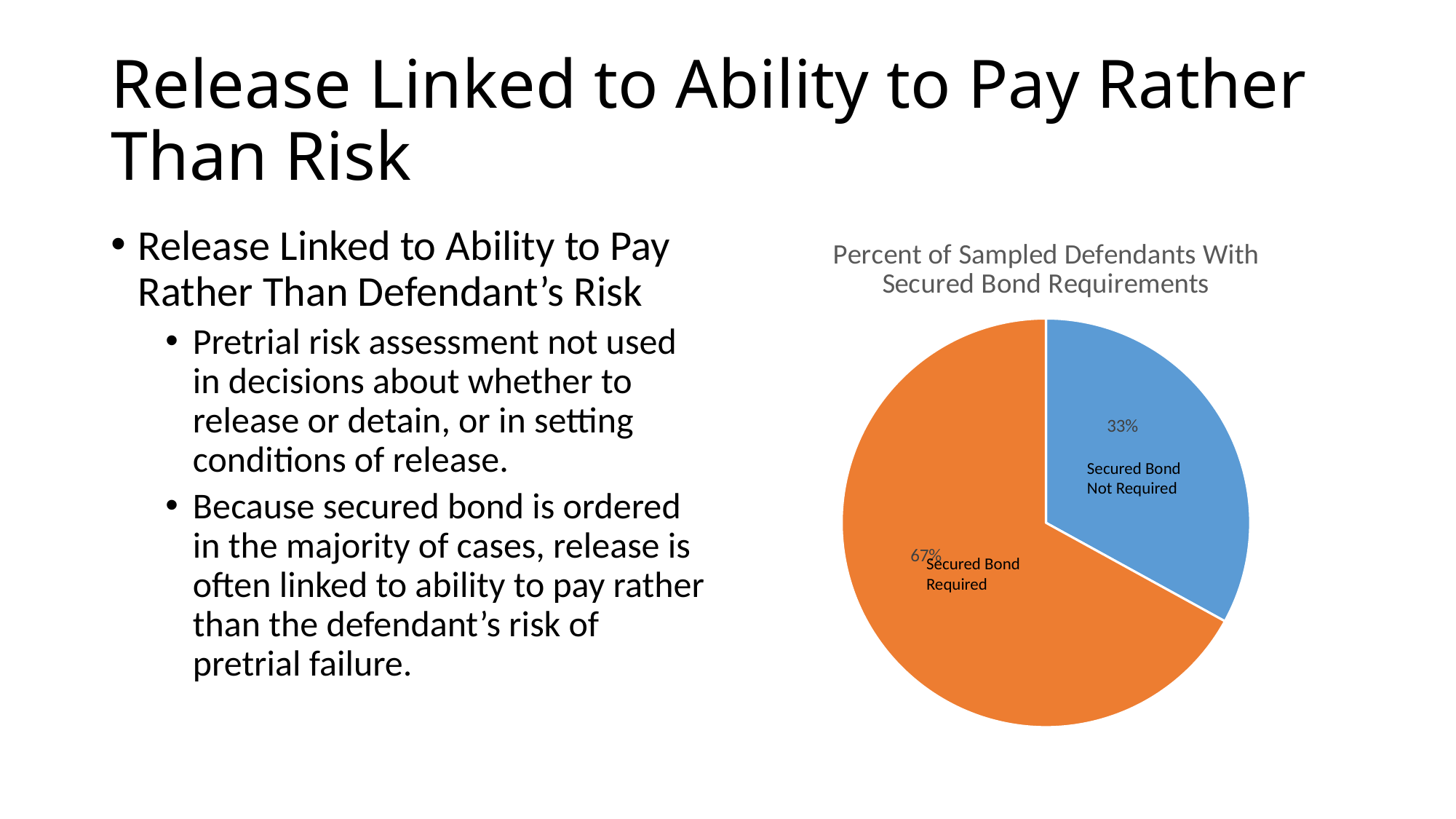
Which is larger: the share for Secured Bond Required or Secured Bond Not Required? Secured Bond Required Which slice of the pie is the largest? Secured Bond Required What colour is the Secured Bond Required slice? orange How many slices does the pie chart have? 2 What percentage of sampled defendants had a secured bond required? 67% Which slice of the pie is the smallest? Secured Bond Not Required What is the title of the chart? Percent of Sampled Defendants With Secured Bond Requirements What is the difference in percentage points between the Secured Bond Required and Secured Bond Not Required slices? 34 What percentage of sampled defendants did not have a secured bond required? 33% What kind of chart is shown on the slide? pie chart What share of the pie does the Secured Bond Not Required slice represent? 33%